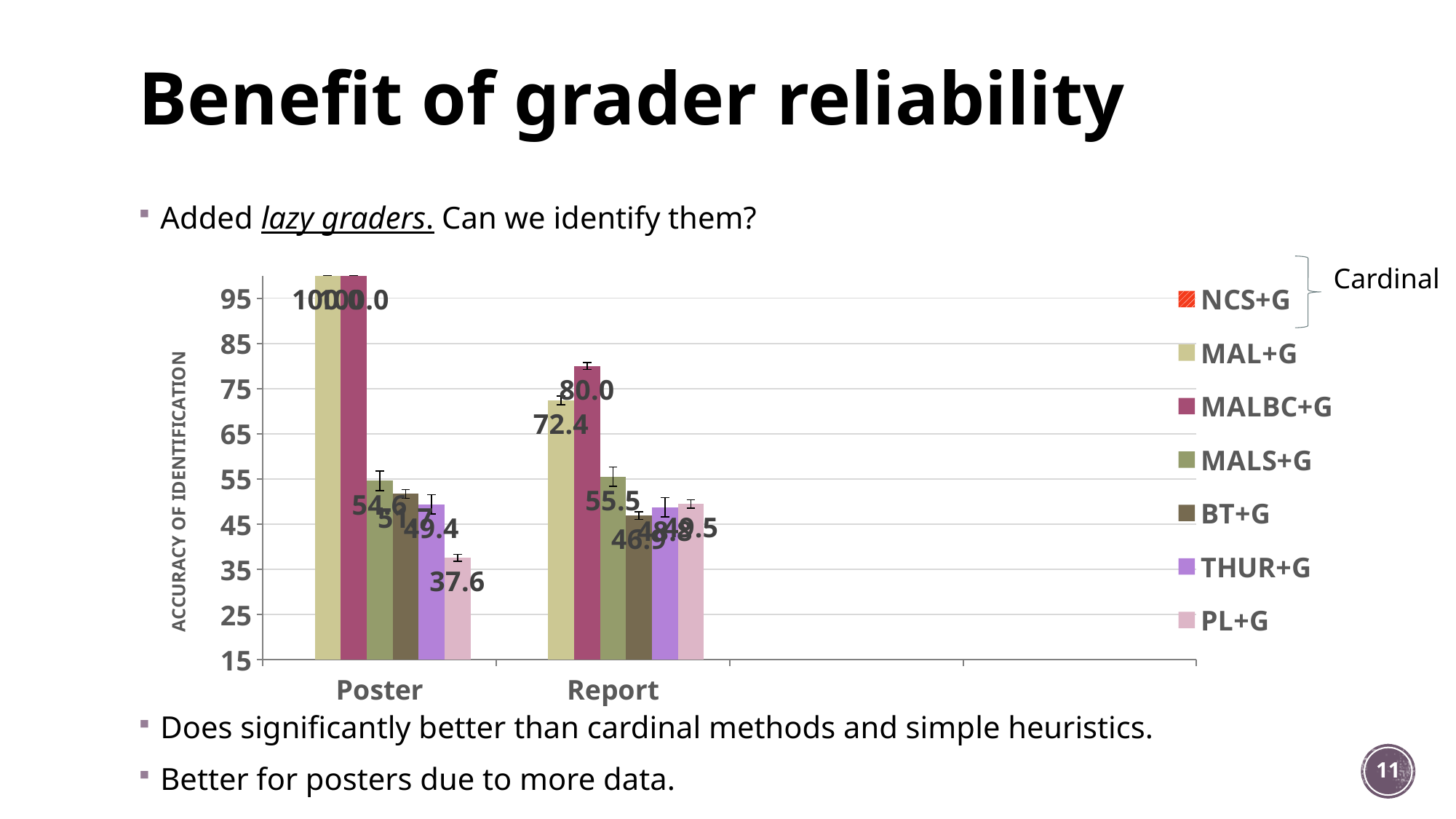
Is the value for THUR+G in the Report category greater or less than 55? less What is the value for MALBC+G in the Report category? 80.0 Which series has the highest value in the Report category? MALBC+G What is the value for MAL+G in the Report category? 72.4 In the Poster category, which is larger: the value for MALS+G or the value for PL+G? MALS+G What is the difference between the MALBC+G and MAL+G values in the Report category? 7.6 What is the value for MALS+G in the Report category? 55.5 How many series does the chart legend list? 7 Which series has the lowest value in the Poster category? PL+G What kind of chart is shown on the slide? Bar chart What is the value for PL+G in the Poster category? 37.6 How many categories are shown on the x axis of the chart? 2